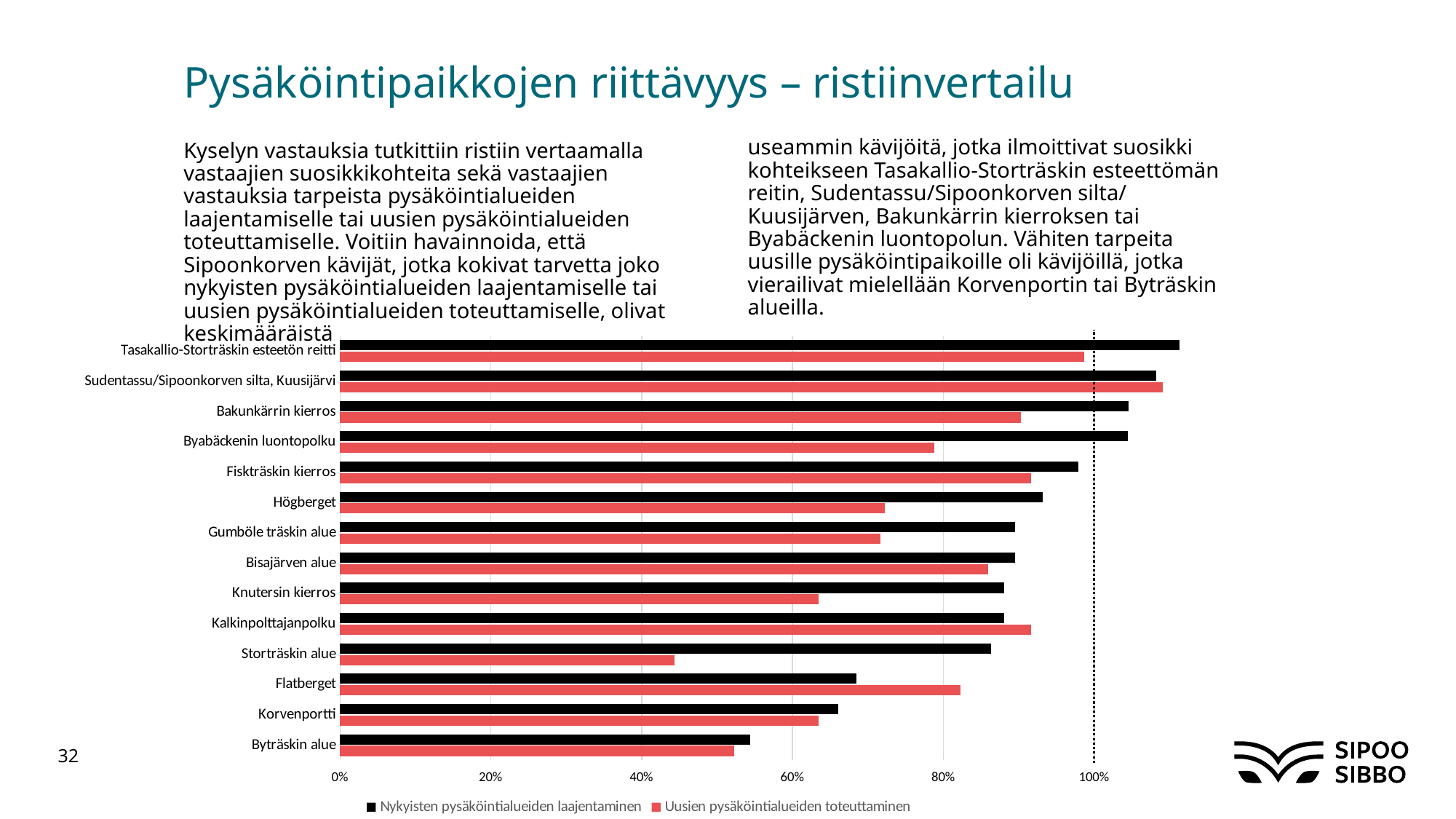
Is the value for Byträskin alue in the 'Nykyisten pysäköintialueiden laajentaminen' series greater or less than 60%? less Which category has the lowest value for 'Nykyisten pysäköintialueiden laajentaminen'? Byträskin alue What is the title of the slide containing the chart? Pysäköintipaikkojen riittävyys – ristiinvertailu Which category has the highest value for 'Nykyisten pysäköintialueiden laajentaminen'? Tasakallio-Storträskin esteetön reitti Is the value for Högberget in the 'Uusien pysäköintialueiden toteuttaminen' series greater or less than 80%? less What kind of chart is shown on the slide? bar chart For Flatberget, which series has the larger value: 'Nykyisten pysäköintialueiden laajentaminen' or 'Uusien pysäköintialueiden toteuttaminen'? Uusien pysäköintialueiden toteuttaminen How many series does the chart legend list? 2 How many categories (routes/areas) are listed on the chart? 14 Is the value for Tasakallio-Storträskin esteetön reitti in the 'Nykyisten pysäköintialueiden laajentaminen' series greater or less than 100%? greater Which category has the lowest value for 'Uusien pysäköintialueiden toteuttaminen'? Storträskin alue Which category has the highest value for 'Uusien pysäköintialueiden toteuttaminen'? Sudentassu/Sipoonkorven silta, Kuusijärvi